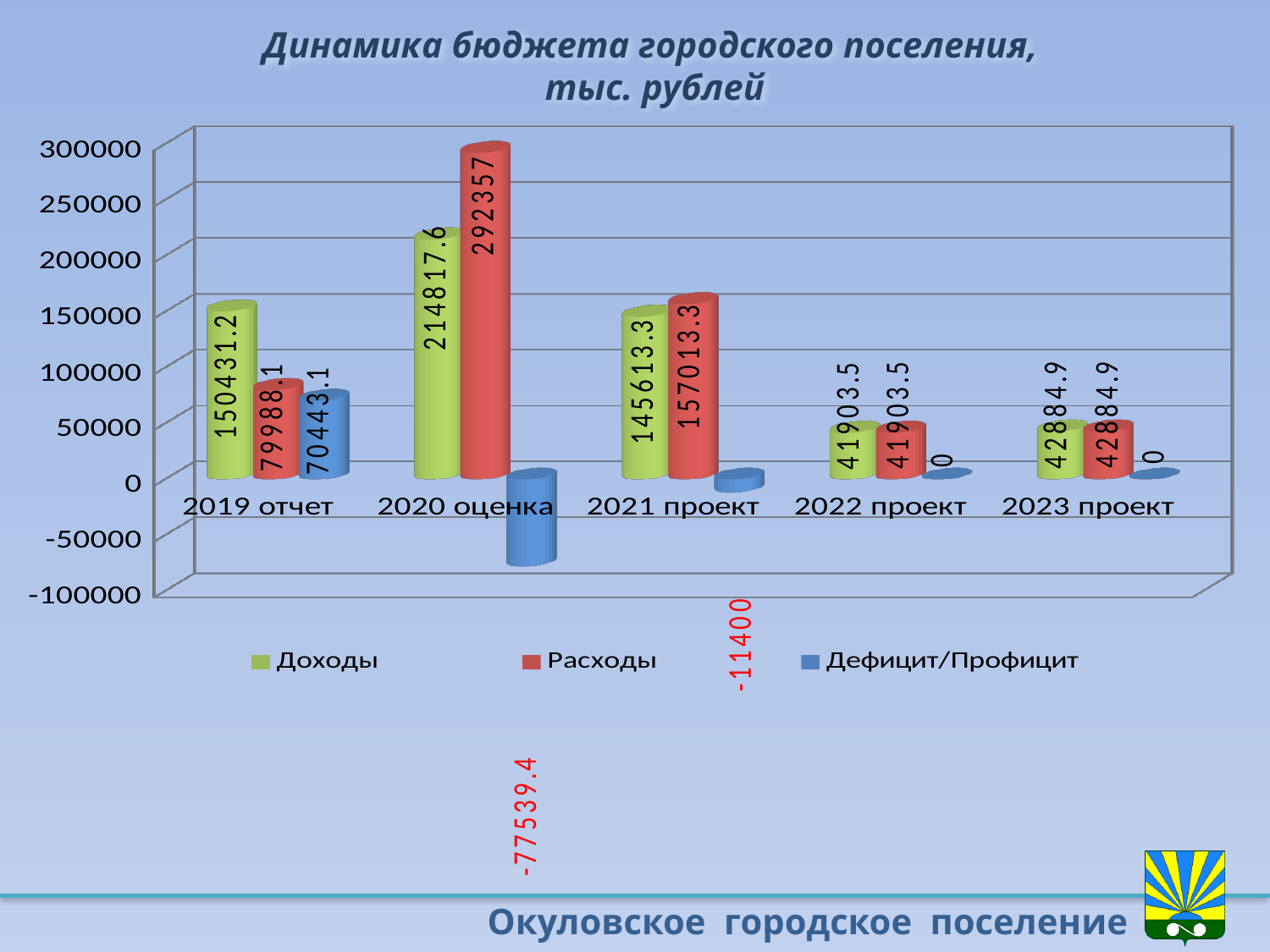
What is the difference between Расходы and Доходы for 2021 проект? 11400 What is the title of the chart? Динамика бюджета городского поселения, тыс. рублей What kind of chart is shown on the slide? Bar chart What is the value of Расходы for 2020 оценка? 292357 How many series does the legend list? 3 How many categories are shown on the x axis? 5 In which category is Доходы the lowest? 2022 проект What is the value of Расходы for 2023 проект? 42884.9 In which category is Расходы the highest? 2020 оценка What is the value of Дефицит/Профицит for 2021 проект? -11400 Which is larger for 2019 отчет, Доходы or Расходы? Доходы What is the value of Доходы for 2019 отчет? 150431.2